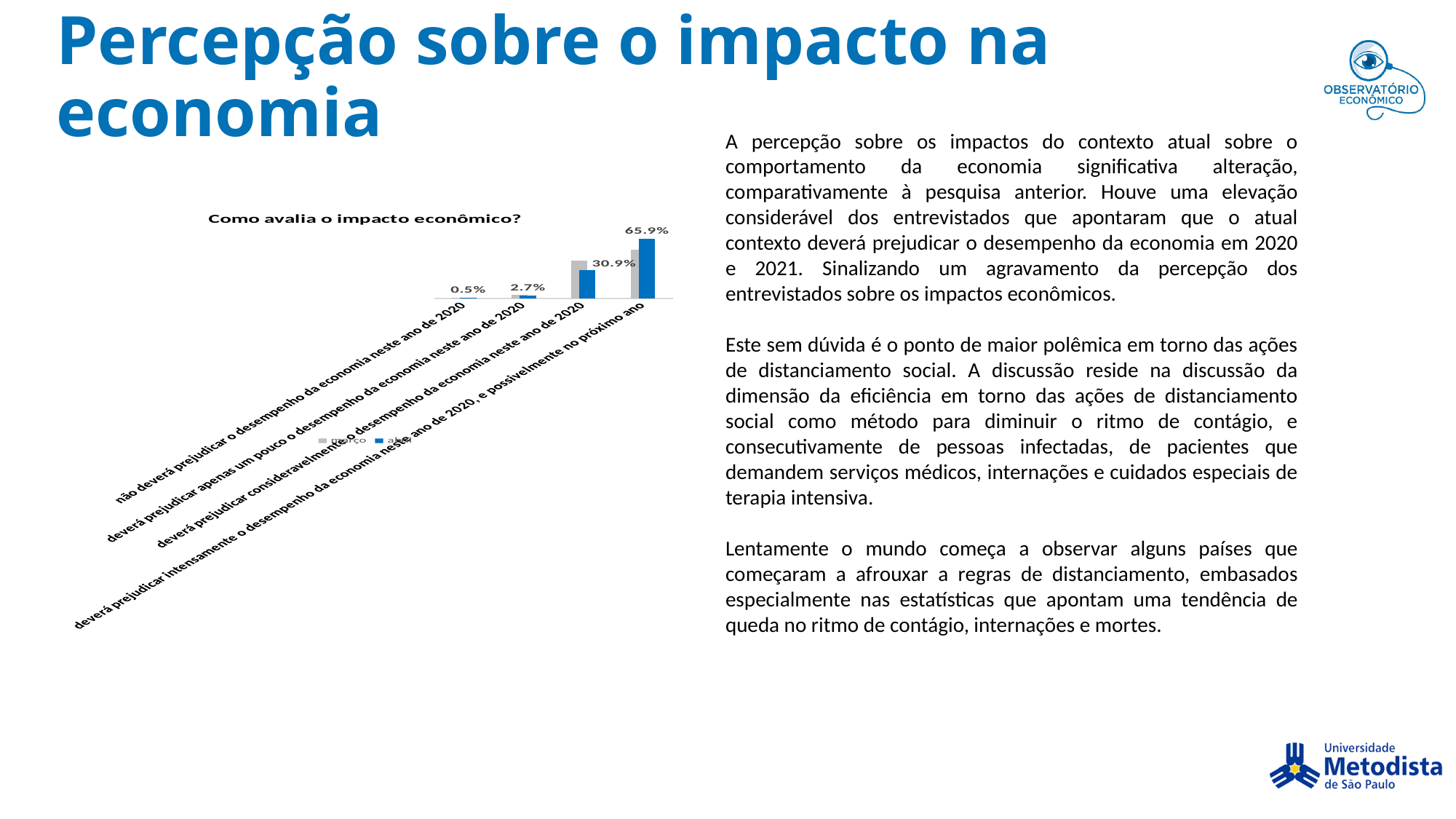
What is the difference between the labeled values 65.9% and 30.9% in the chart? 35.0% Which category has the highest labeled value in the chart? deverá prejudicar intensamente o desempenho da economia neste ano de 2020, e possivelmente no próximo ano Do the labeled values rise or fall moving from left to right along the x axis? rise How many series does the chart's legend list? 2 Which category has the lowest labeled value in the chart? não deverá prejudicar o desempenho da economia neste ano de 2020 What data label is shown for the category 'deverá prejudicar apenas um pouco o desempenho da economia neste ano de 2020'? 2.7% In the category 'deverá prejudicar consideravelmente o desempenho da economia neste ano de 2020', is the grey bar or the blue bar taller? grey How many categories are shown on the x axis of the chart? 4 What kind of chart is shown on the slide? bar chart What is the title of the chart on the slide? Como avalia o impacto econômico? What data label is shown for the category 'deverá prejudicar intensamente o desempenho da economia neste ano de 2020, e possivelmente no próximo ano'? 65.9% What data label is shown for the category 'deverá prejudicar consideravelmente o desempenho da economia neste ano de 2020'? 30.9%